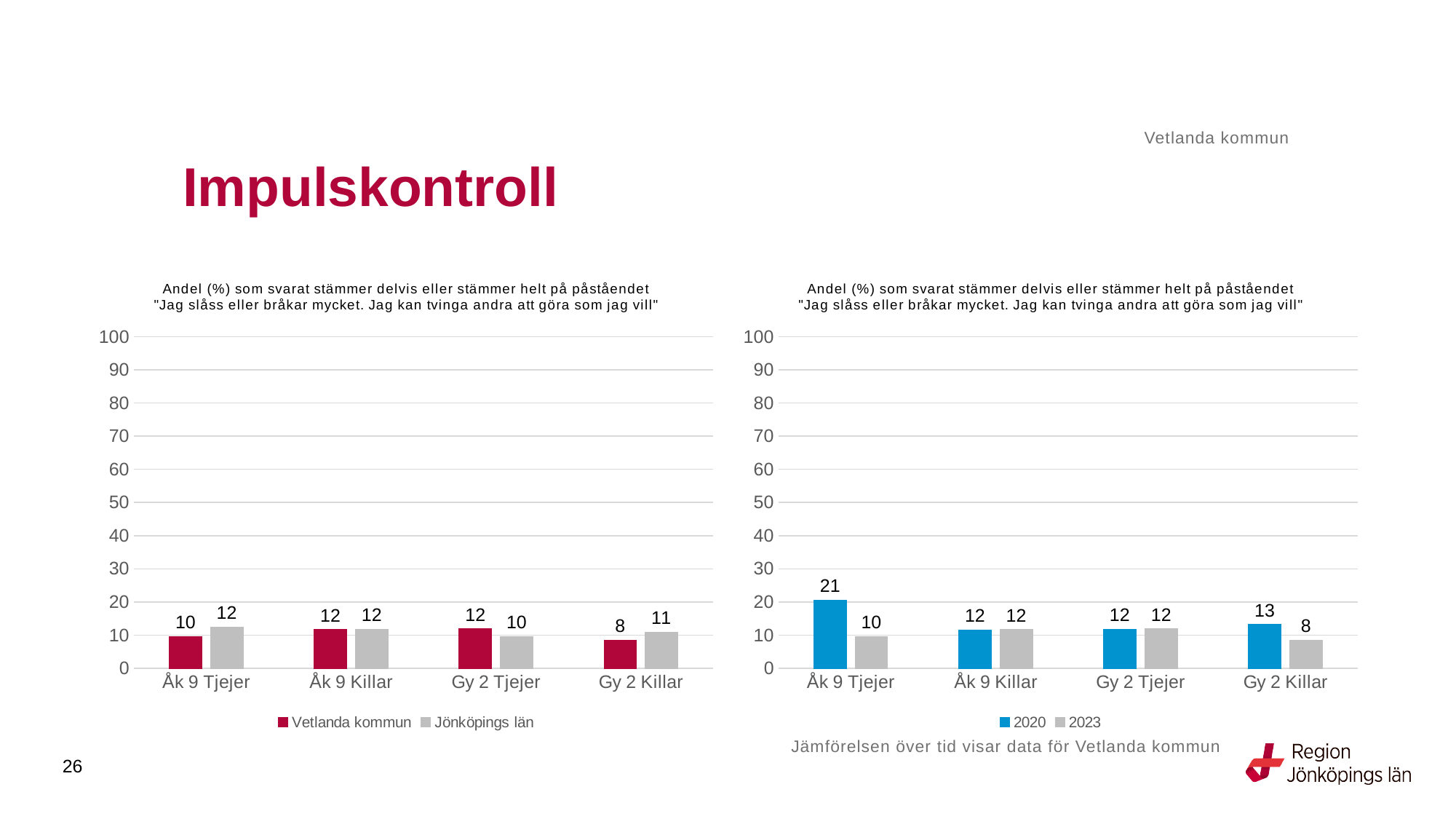
In the right chart, what is the value for 2020 for Åk 9 Tjejer? 21 How many series does the legend of the right chart list? 2 In the left chart, which is larger for Gy 2 Tjejer: Vetlanda kommun or Jönköpings län? Vetlanda kommun How many categories are shown on the x axis of the left chart? 4 In the right chart, what is the difference between the 2020 and 2023 values for Åk 9 Tjejer? 11 In the left chart, what is the value for Jönköpings län for Åk 9 Tjejer? 12 In the right chart, what is the value for 2023 for Gy 2 Killar? 8 In the right chart, is the value for 2020 for Åk 9 Tjejer greater or less than 20? greater In the left chart, what is the difference between the Jönköpings län and Vetlanda kommun values for Gy 2 Killar? 3 In the left chart, what is the value for Vetlanda kommun for Gy 2 Killar? 8 In the left chart, which category has the lowest value for Vetlanda kommun? Gy 2 Killar In the right chart, which category has the highest value for 2020? Åk 9 Tjejer